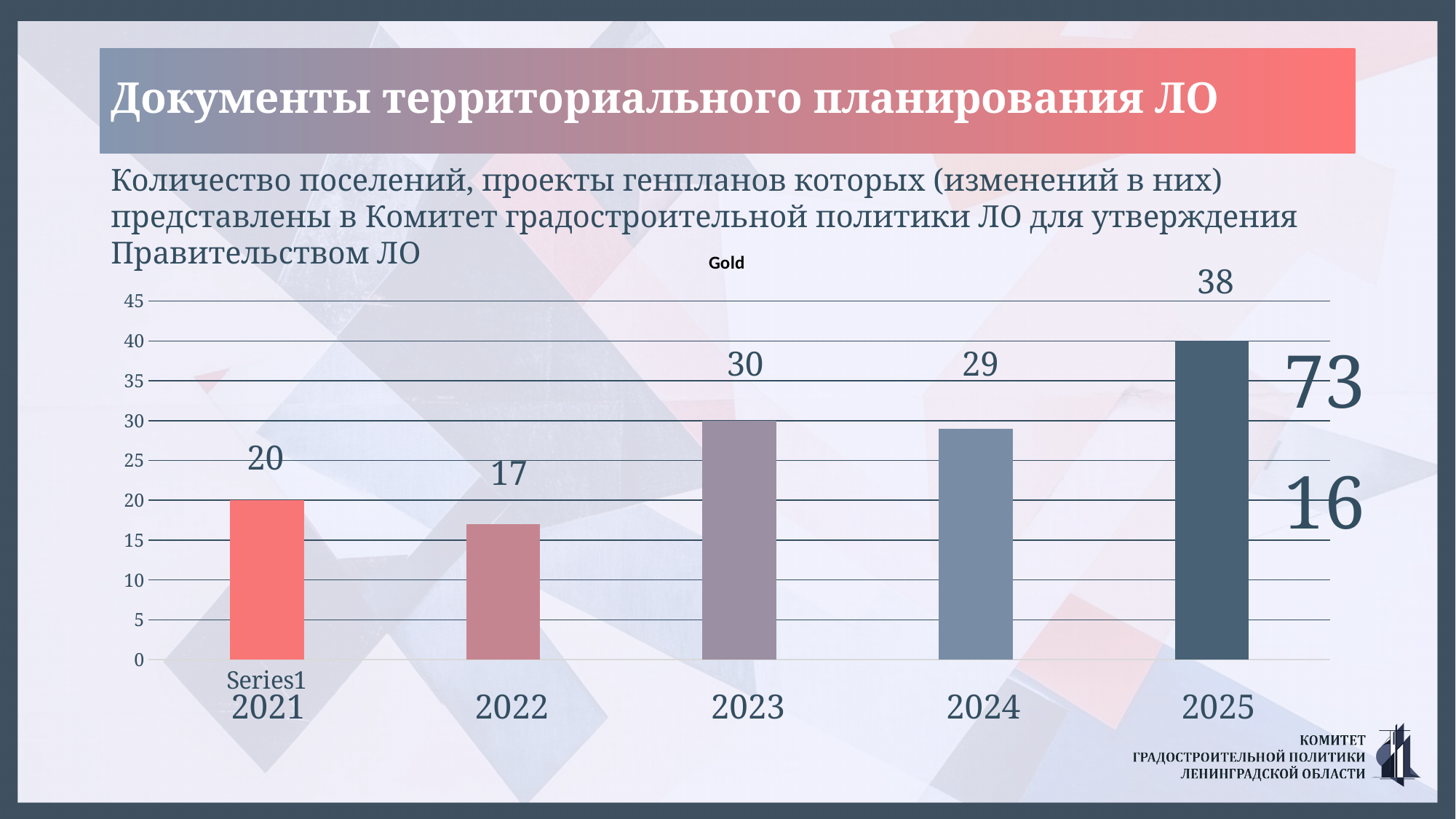
Which year has the highest value? 2025 What is the title printed above the chart? Gold Which is larger, the value for 2021 or the value for 2022? 2021 What is the value for 2022? 17 Which year has the lowest value? 2022 What is the value for 2023? 30 What is the value for 2021? 20 How many years are shown on the x axis? 5 What is the difference between the values for 2023 and 2021? 10 What type of chart is shown on the slide? bar chart What is the value for 2025? 38 What is the value for 2024? 29